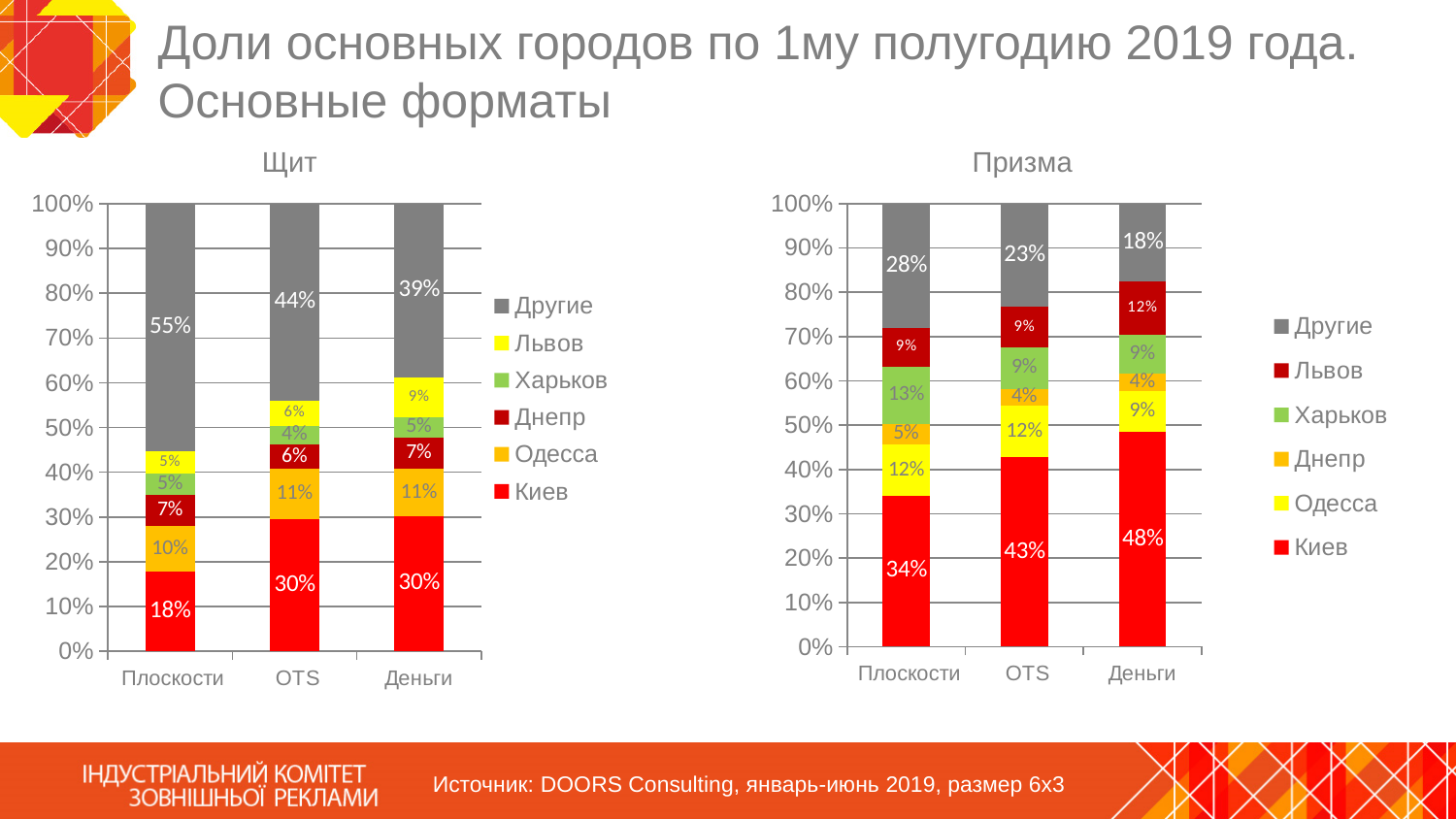
In the Призма chart, do the Киев values rise or fall from Плоскости to Деньги? Rise In the Призма chart, which category has the lowest value for Киев? Плоскости In the Щит chart, which is larger: Киев for OTS or Киев for Плоскости? Киев for OTS In the Щит chart, what is the value for Киев in the Плоскости bar? 18% In the Призма chart, what is the difference between the Другие values for Плоскости and Деньги? 10% In the Щит chart, which category has the highest value for Другие? Плоскости In the Призма chart, what is the value for Харьков in the Плоскости bar? 13% In the Призма chart, what is the value for Киев in the Деньги bar? 48% What kind of chart is the Призма chart? Stacked bar chart In the Щит chart, what is the value for Другие in the OTS bar? 44% How many series does the legend of the Щит chart list? 6 How many categories are shown on the x axis of the Призма chart? 3